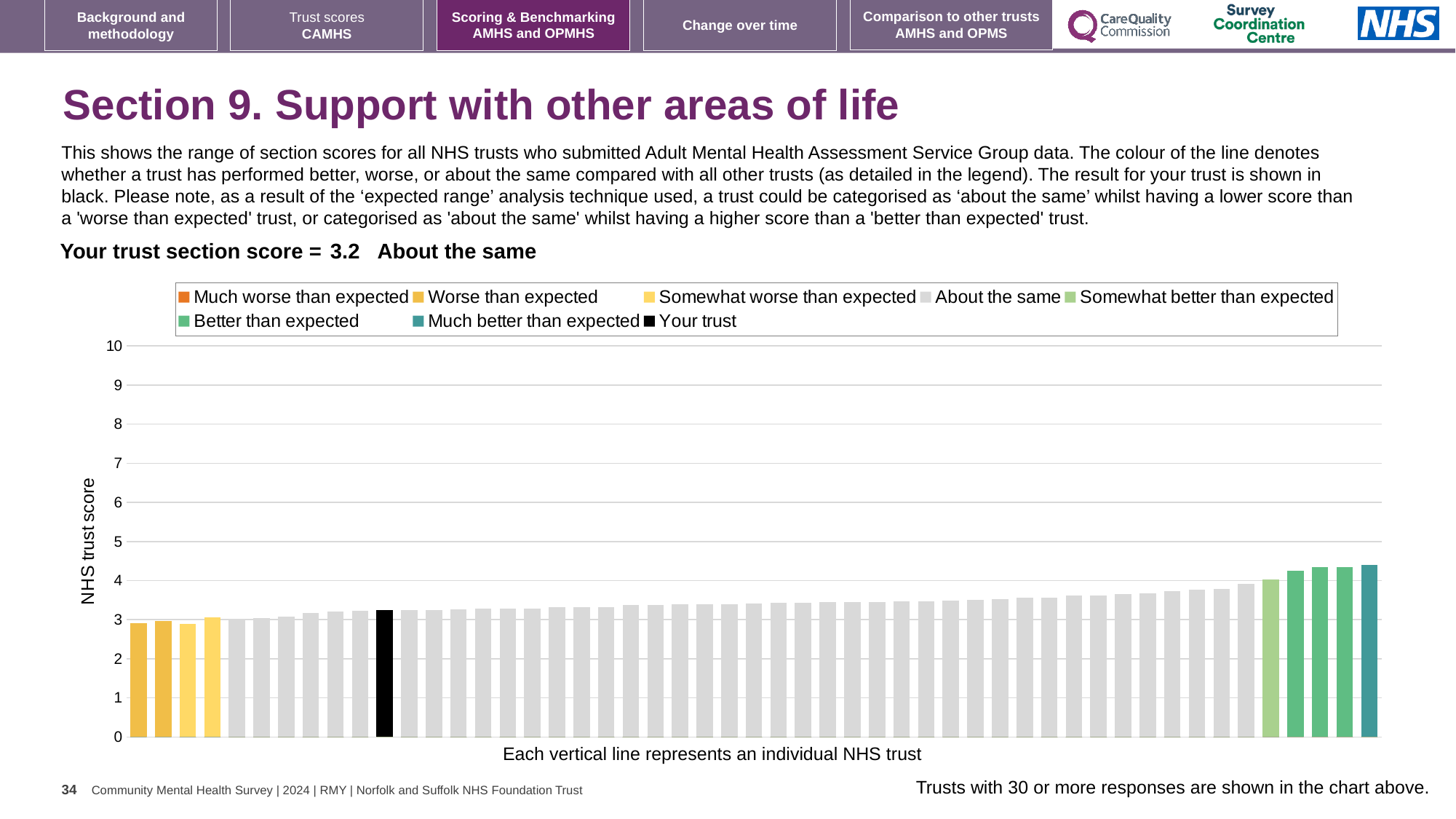
What kind of chart is shown on the slide? bar chart Is the value for your trust greater or less than 3? greater What is the section score for your trust shown on the slide? 3.2 Is the tallest bar in the chart greater or less than 4? greater Is the tallest bar in the chart greater or less than 5? less What is the highest value shown on the y axis? 10 What is the label of the y axis? NHS trust score How many entries does the chart legend list? 8 Which legend category does the tallest bar belong to? Much better than expected Do the bar values rise or fall from left to right along the x axis? rise